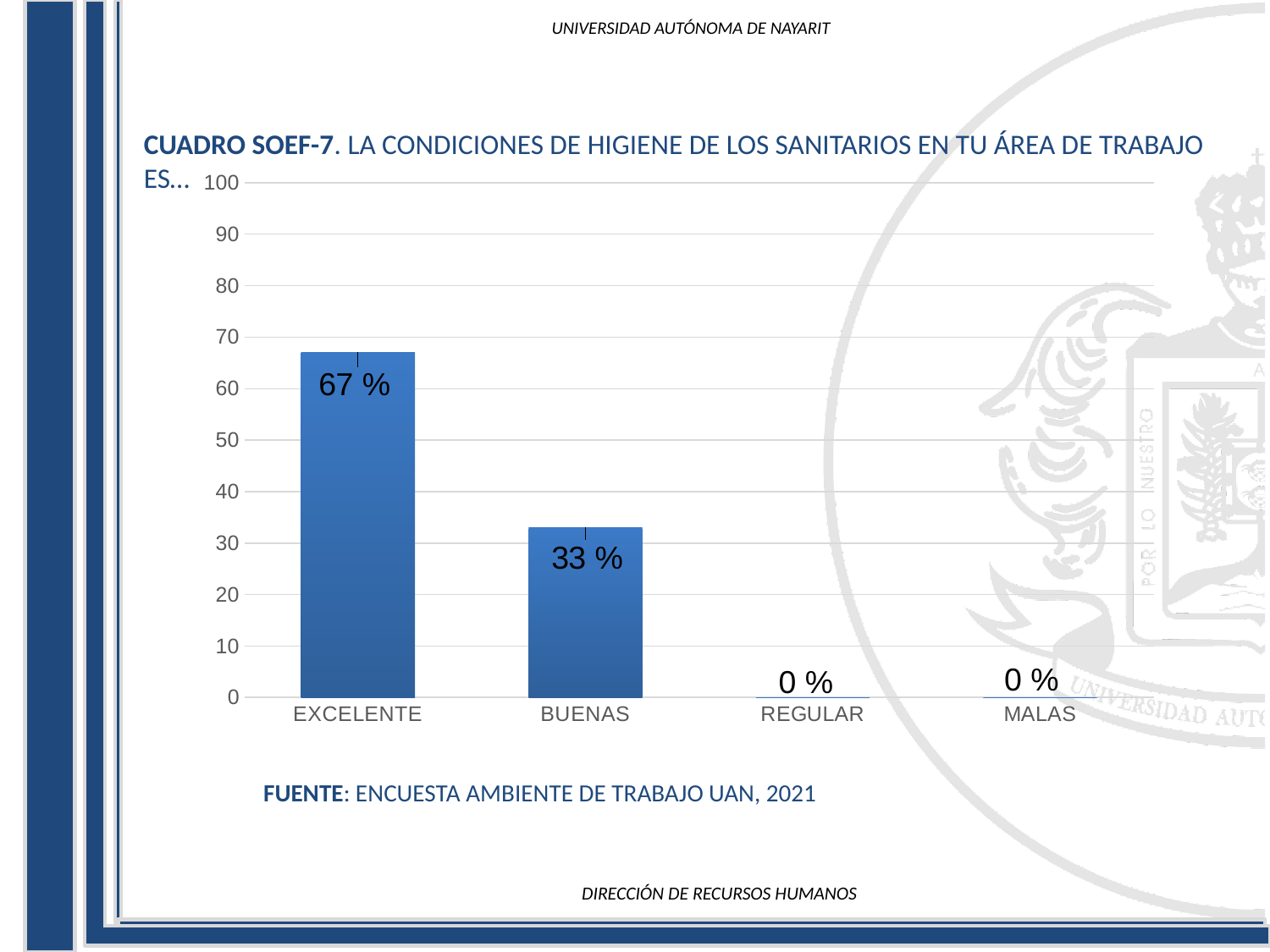
What is the value for EXCELENTE? 67 % What is the difference between the values for EXCELENTE and BUENAS? 34 % Is the value for BUENAS greater or less than 40? less What is the value for MALAS? 0 % What kind of chart is shown on the slide? bar chart What is the source cited below the chart? ENCUESTA AMBIENTE DE TRABAJO UAN, 2021 How many categories are shown on the x axis? 4 Which is larger, the value for EXCELENTE or the value for BUENAS? EXCELENTE What is the value for BUENAS? 33 % Which category has the highest value? EXCELENTE Is the value for EXCELENTE greater or less than 60? greater What is the value for REGULAR? 0 %